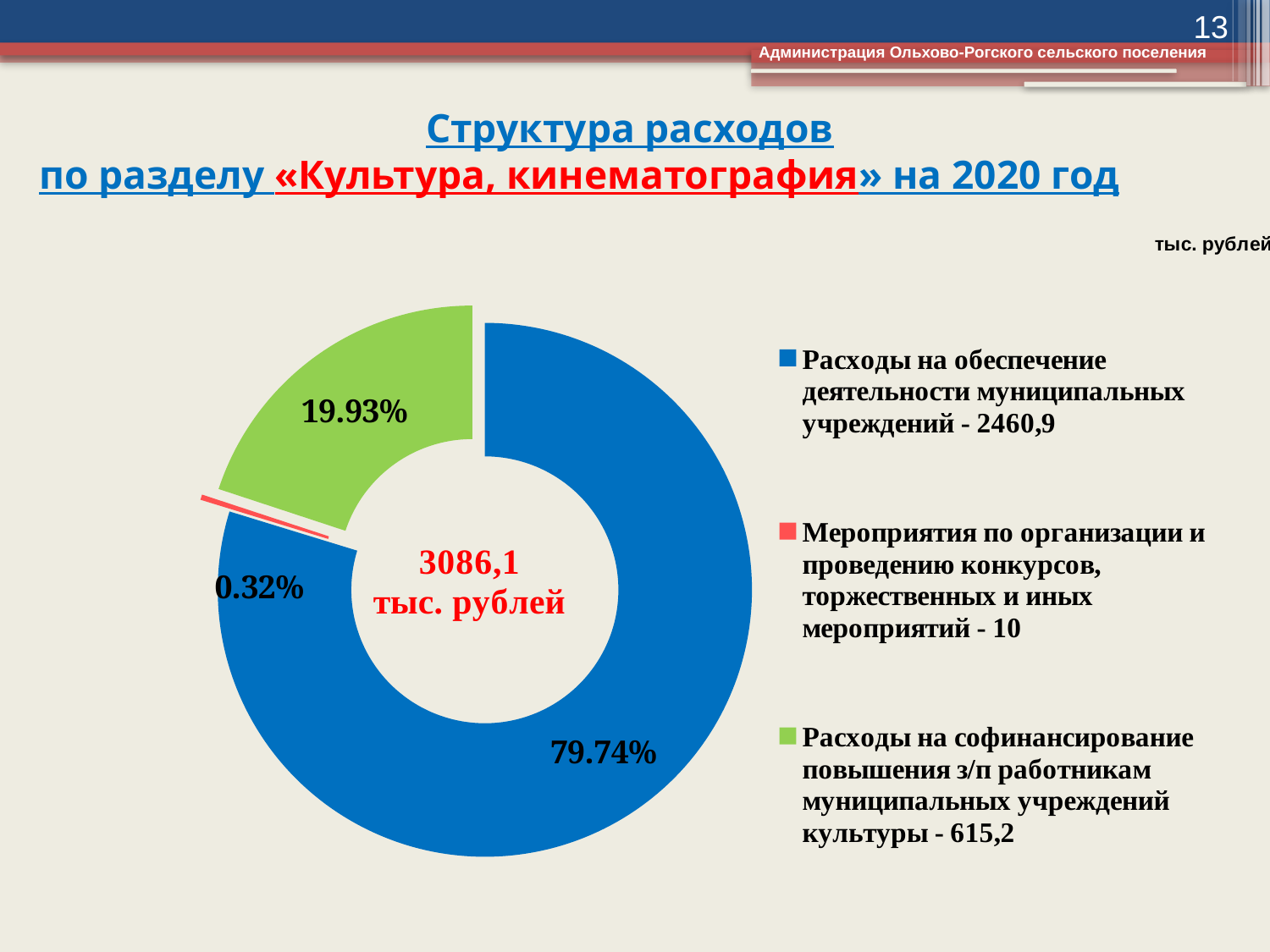
What amount (тыс. рублей) is given in the legend for «Расходы на обеспечение деятельности муниципальных учреждений»? 2460,9 What share of the chart does the slice for «Расходы на софинансирование повышения з/п работникам муниципальных учреждений культуры» represent? 19.93% Which category has the largest share of the chart? Расходы на обеспечение деятельности муниципальных учреждений Which category has the smallest share of the chart? Мероприятия по организации и проведению конкурсов, торжественных и иных мероприятий What kind of chart is shown on the slide? Doughnut (pie) chart What colour is the slice for «Расходы на софинансирование повышения з/п работникам муниципальных учреждений культуры»? Green How many categories does the chart show? 3 What share of the chart does the slice for «Расходы на обеспечение деятельности муниципальных учреждений» represent? 79.74% What is the total amount shown in the centre of the chart? 3086,1 тыс. рублей What share of the chart does the slice for «Мероприятия по организации и проведению конкурсов, торжественных и иных мероприятий» represent? 0.32% What amount (тыс. рублей) is given in the legend for «Мероприятия по организации и проведению конкурсов, торжественных и иных мероприятий»? 10 What amount (тыс. рублей) is given in the legend for «Расходы на софинансирование повышения з/п работникам муниципальных учреждений культуры»? 615,2